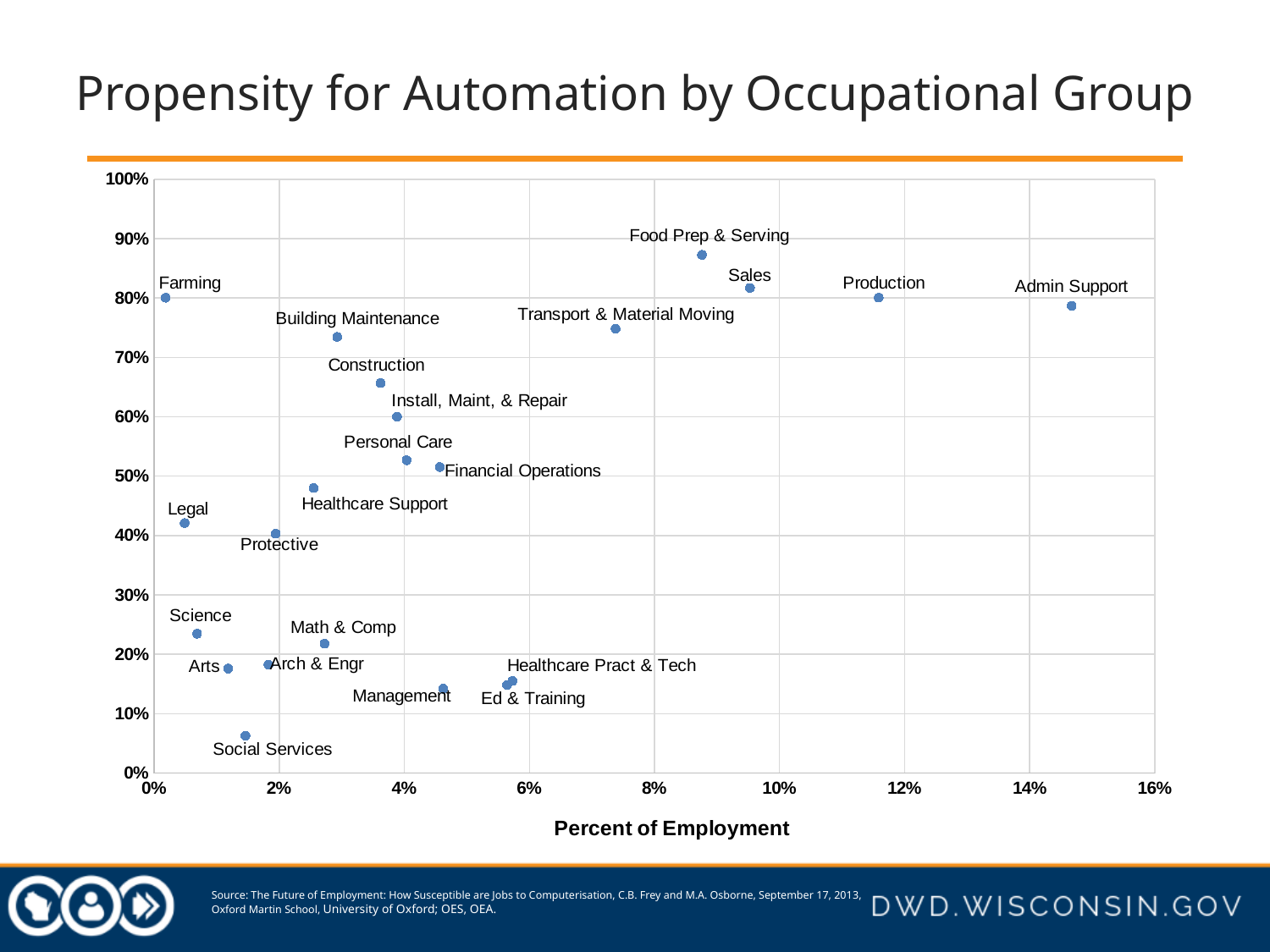
Which occupational group has the lowest propensity for automation? Social Services Which occupational group has the highest percent of employment? Admin Support Which has a higher propensity for automation, Construction or Install, Maint, & Repair? Construction Is the propensity for automation for Social Services greater or less than 10%? less What is the title of the horizontal axis? Percent of Employment Is the propensity for automation for Food Prep & Serving greater or less than 80%? greater Is the percent of employment for Production greater or less than 10%? greater Which has a higher propensity for automation, Farming or Legal? Farming Which occupational group has the highest propensity for automation? Food Prep & Serving Which occupational group has the lowest percent of employment? Farming How many occupational groups are plotted on the chart? 22 What kind of chart is shown on the slide? scatter chart